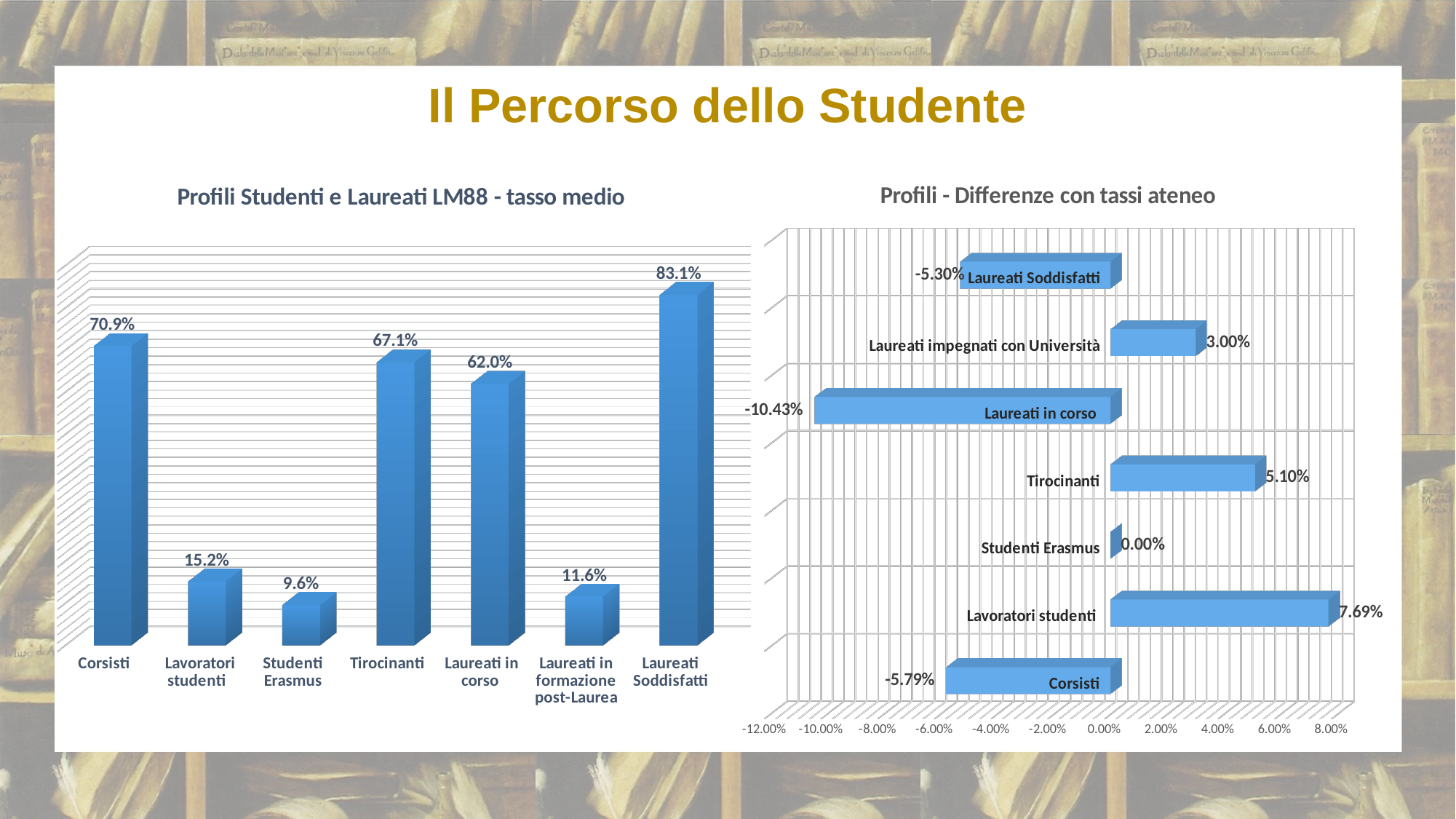
In the chart 'Profili Studenti e Laureati LM88 - tasso medio', what is the value for Tirocinanti? 67.1% In the chart 'Profili Studenti e Laureati LM88 - tasso medio', what is the difference between Corsisti and Laureati in corso? 8.9% In the chart 'Profili Studenti e Laureati LM88 - tasso medio', which is larger: Lavoratori studenti or Laureati in formazione post-Laurea? Lavoratori studenti In the chart 'Profili Studenti e Laureati LM88 - tasso medio', which category has the lowest value? Studenti Erasmus In the chart 'Profili - Differenze con tassi ateneo', what is the difference between Tirocinanti and Laureati impegnati con Università? 2.10% What type of chart is 'Profili - Differenze con tassi ateneo'? Bar chart In the chart 'Profili Studenti e Laureati LM88 - tasso medio', how many categories are shown? 7 In the chart 'Profili Studenti e Laureati LM88 - tasso medio', which category has the highest value? Laureati Soddisfatti In the chart 'Profili - Differenze con tassi ateneo', which category has the highest value? Lavoratori studenti In the chart 'Profili - Differenze con tassi ateneo', what is the value for Laureati in corso? -10.43% In the chart 'Profili - Differenze con tassi ateneo', what is the value for Lavoratori studenti? 7.69% In the chart 'Profili - Differenze con tassi ateneo', which category has the lowest value? Laureati in corso